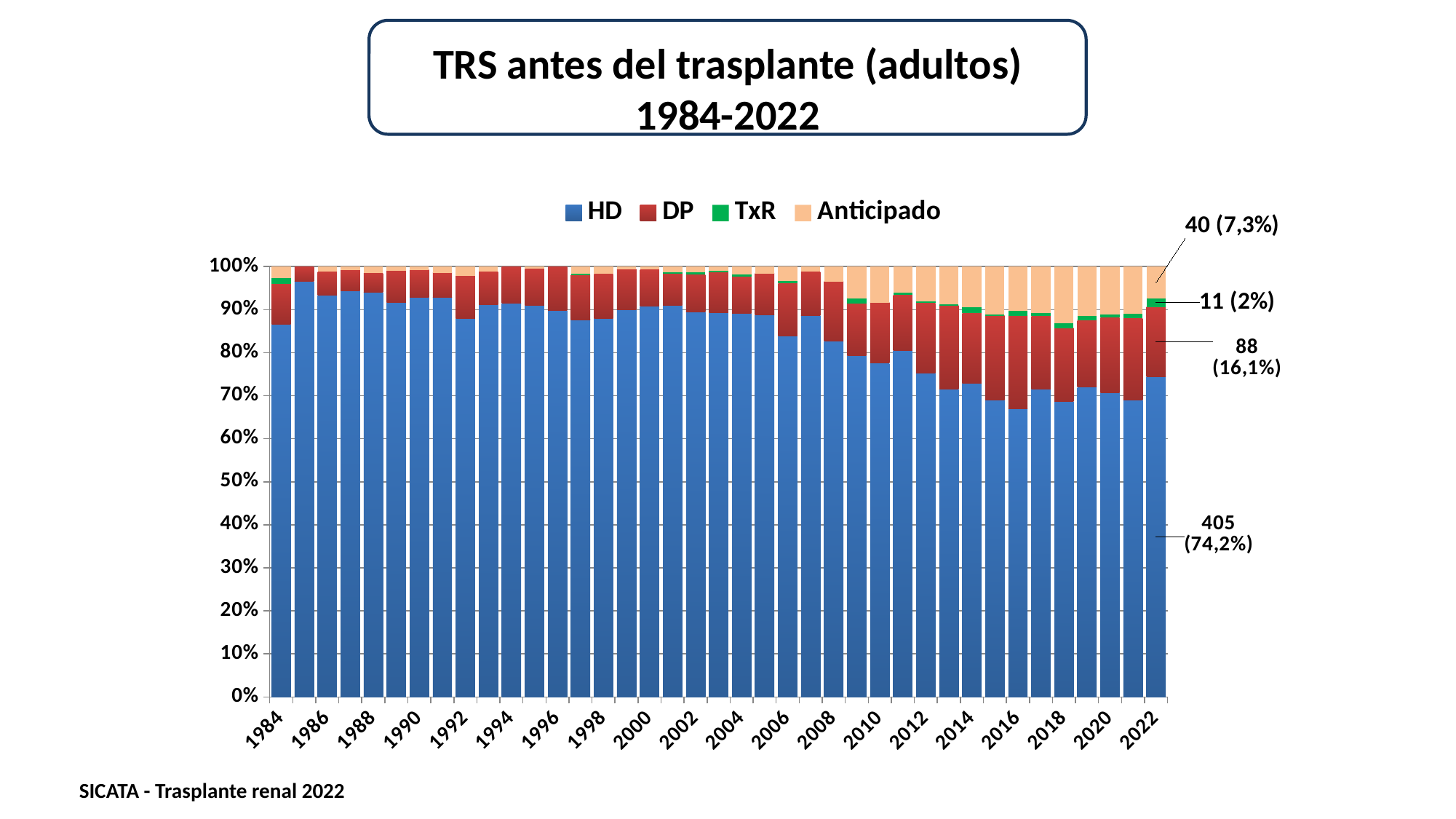
What is the labelled value for DP in 2022? 88 (16,1%) What is the total number of patients across all four series in 2022? 544 What kind of chart is shown on the slide? Stacked bar chart What is the labelled value for HD in 2022? 405 (74,2%) How many series does the legend list? 4 Does the HD share generally rise or fall from 1984 to 2022? fall What is the labelled value for TxR in 2022? 11 (2%) What are the series listed in the legend? HD, DP, TxR, Anticipado What is the labelled value for Anticipado in 2022? 40 (7,3%) Which series has the smallest share in 2022? TxR How many years (bars) are plotted on the x axis? 39 Is the HD share in 1984 greater or less than 80%? greater